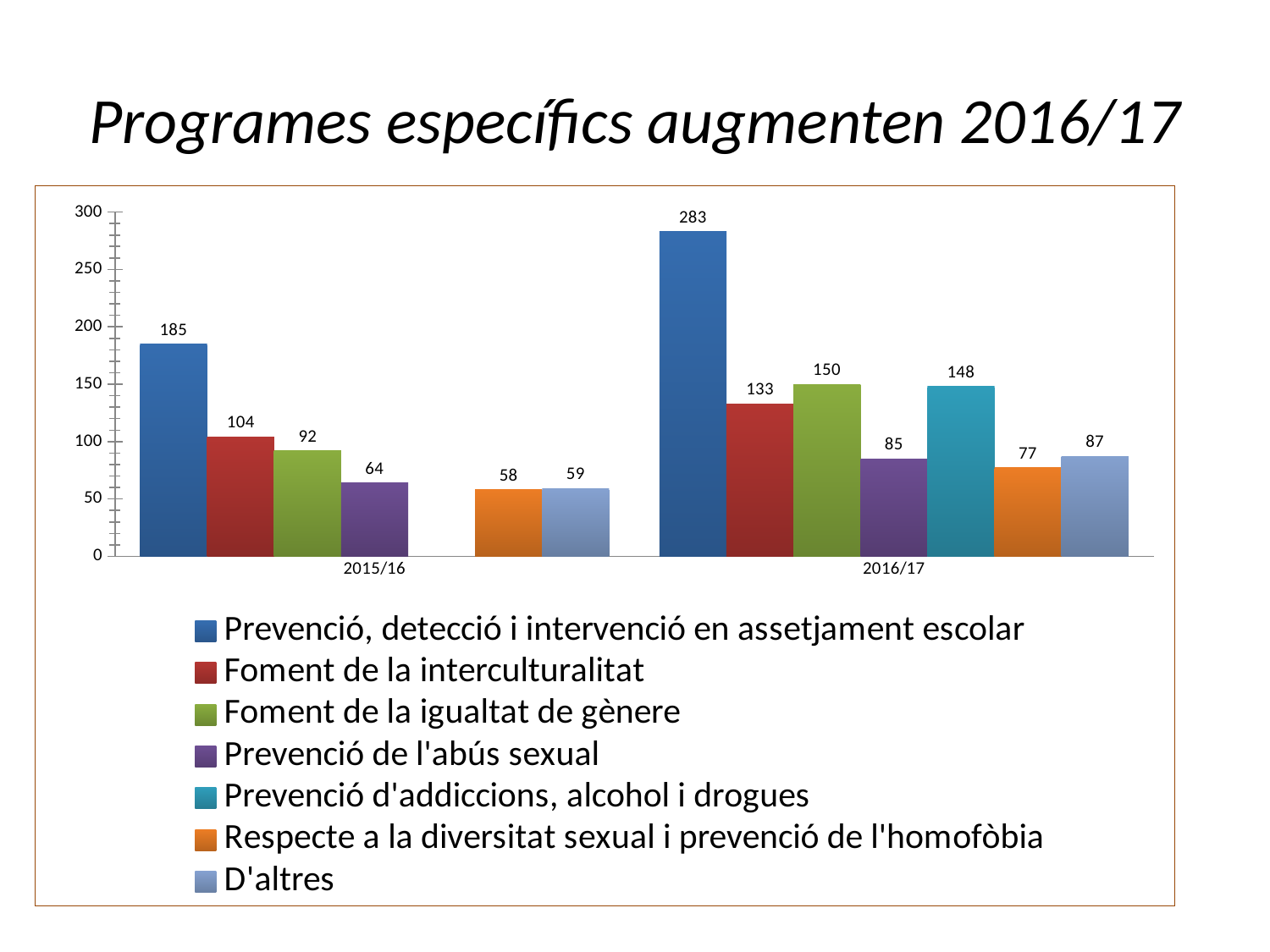
What kind of chart is shown on the slide? Bar chart What is the value for "Prevenció, detecció i intervenció en assetjament escolar" in 2016/17? 283 Which series has the lowest value in 2015/16? Respecte a la diversitat sexual i prevenció de l'homofòbia Which is larger in 2016/17: "Foment de la igualtat de gènere" or "Foment de la interculturalitat"? Foment de la igualtat de gènere What is the difference between the 2016/17 and 2015/16 values for "Prevenció, detecció i intervenció en assetjament escolar"? 98 What is the value for "D'altres" in 2015/16? 59 How many series does the legend list? 7 What is the value for "Prevenció d'addiccions, alcohol i drogues" in 2016/17? 148 What is the value for "Foment de la igualtat de gènere" in 2015/16? 92 What is the title of the slide? Programes específics augmenten 2016/17 Which series has the highest value in 2016/17? Prevenció, detecció i intervenció en assetjament escolar What is the difference between the 2016/17 and 2015/16 values for "Foment de la interculturalitat"? 29